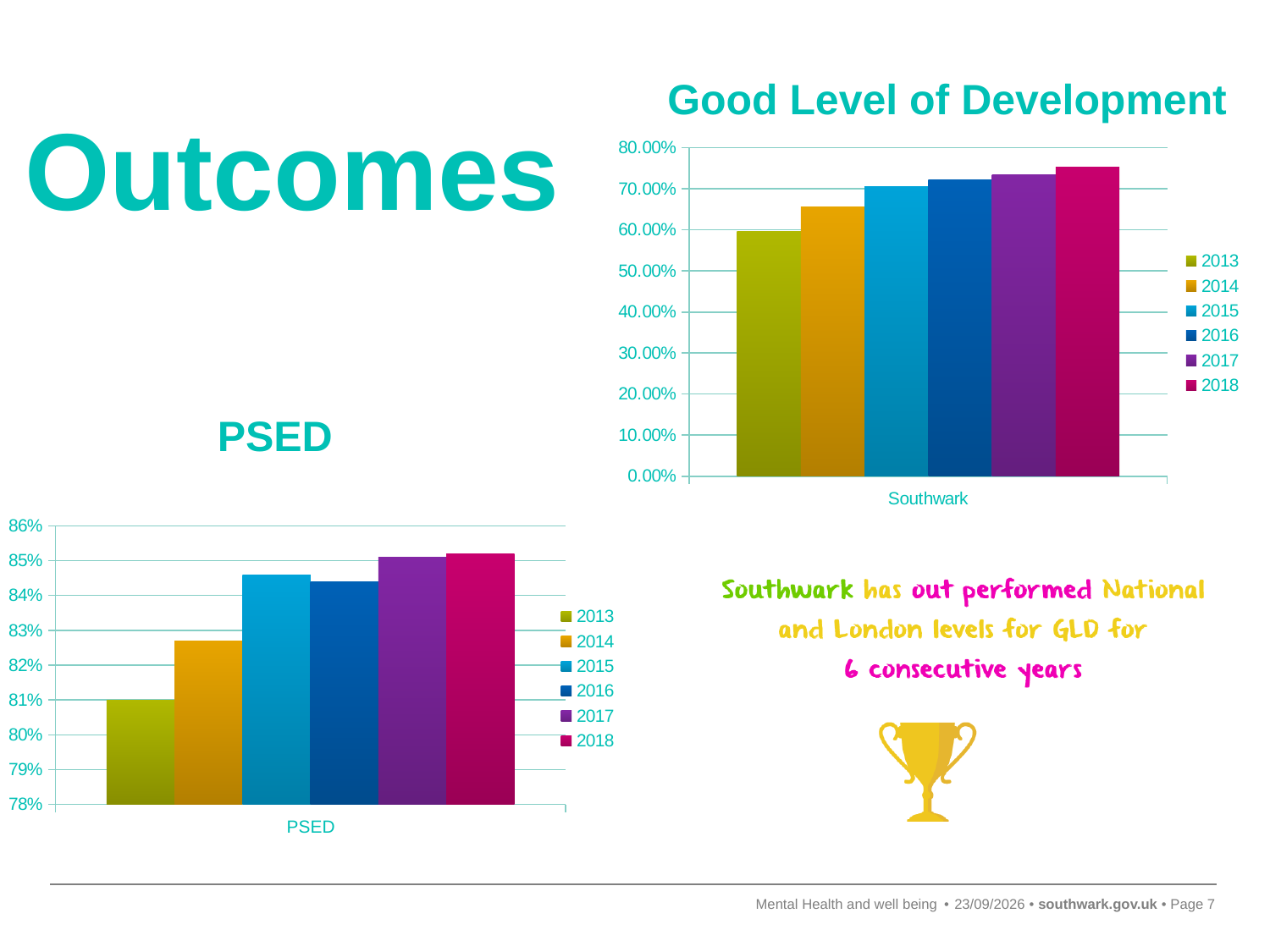
In the Good Level of Development chart, is the value for 2014 greater or less than 60.00%? greater In the Good Level of Development chart, do the values rise or fall from 2013 to 2018? rise How many series does the legend of the Good Level of Development chart list? 6 In the PSED chart, which year has the lowest value? 2013 In the PSED chart, which is larger, the value for 2015 or the value for 2014? 2015 What kind of chart is the Good Level of Development chart? bar chart In the Good Level of Development chart, is the value for 2018 greater or less than 70.00%? greater In the Good Level of Development chart, which year has the highest value? 2018 What is the category label on the x axis of the Good Level of Development chart? Southwark How many series does the legend of the PSED chart list? 6 In the PSED chart, is the value for 2014 greater or less than 82%? greater In the Good Level of Development chart, which year has the lowest value? 2013